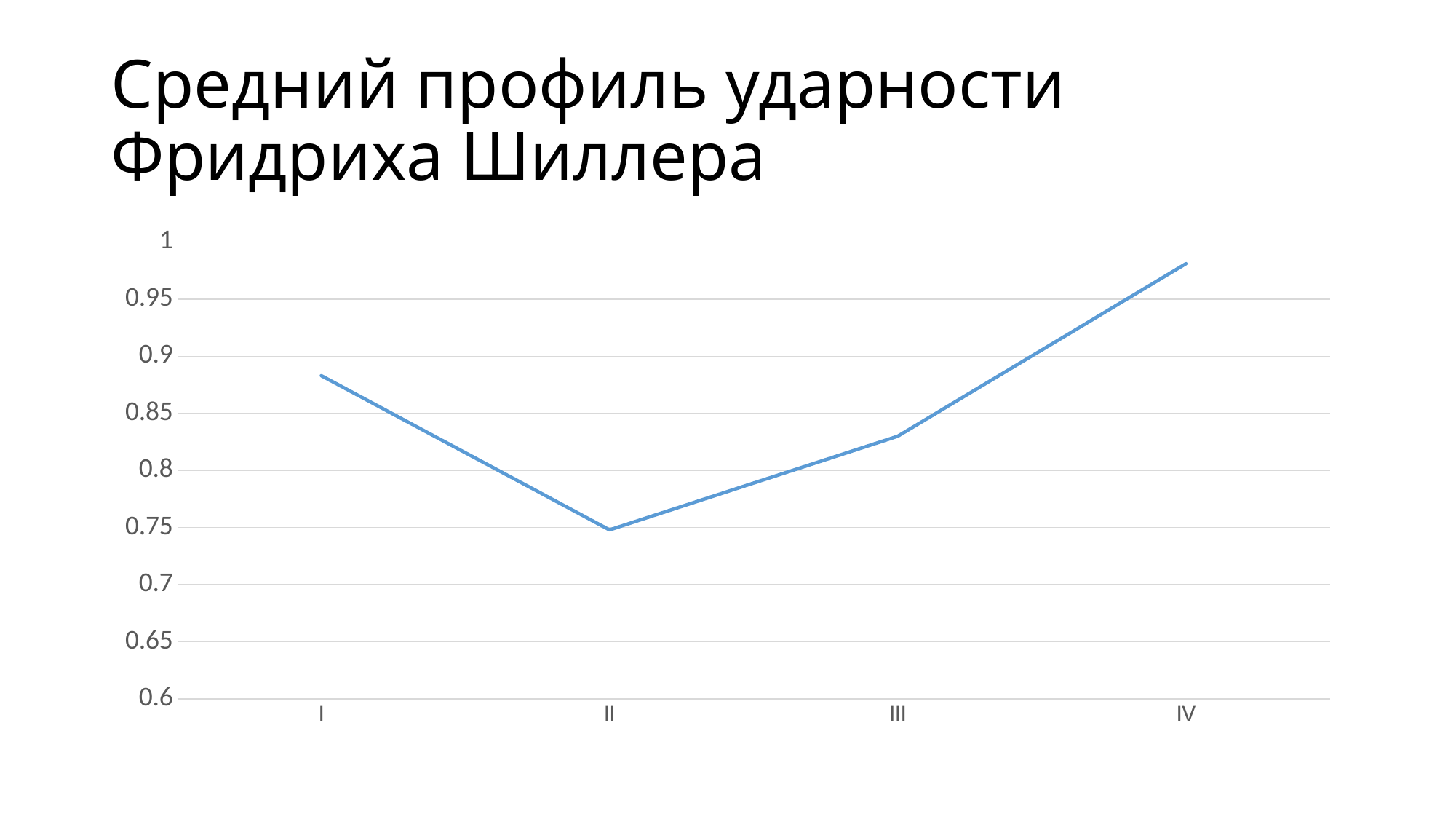
What is the title of the chart on the slide? Средний профиль ударности Фридриха Шиллера Does the value rise or fall from I to II? fall Does the value rise or fall from II to IV? rise Which category has the highest value? IV Is the value for IV greater or less than 0.95? greater How many points are plotted on the line? 4 Which category has the lowest value? II Is the value for I greater or less than 0.85? greater Is the value for II greater or less than 0.8? less What kind of chart is shown on the slide? line chart Which is larger, the value for I or the value for III? I